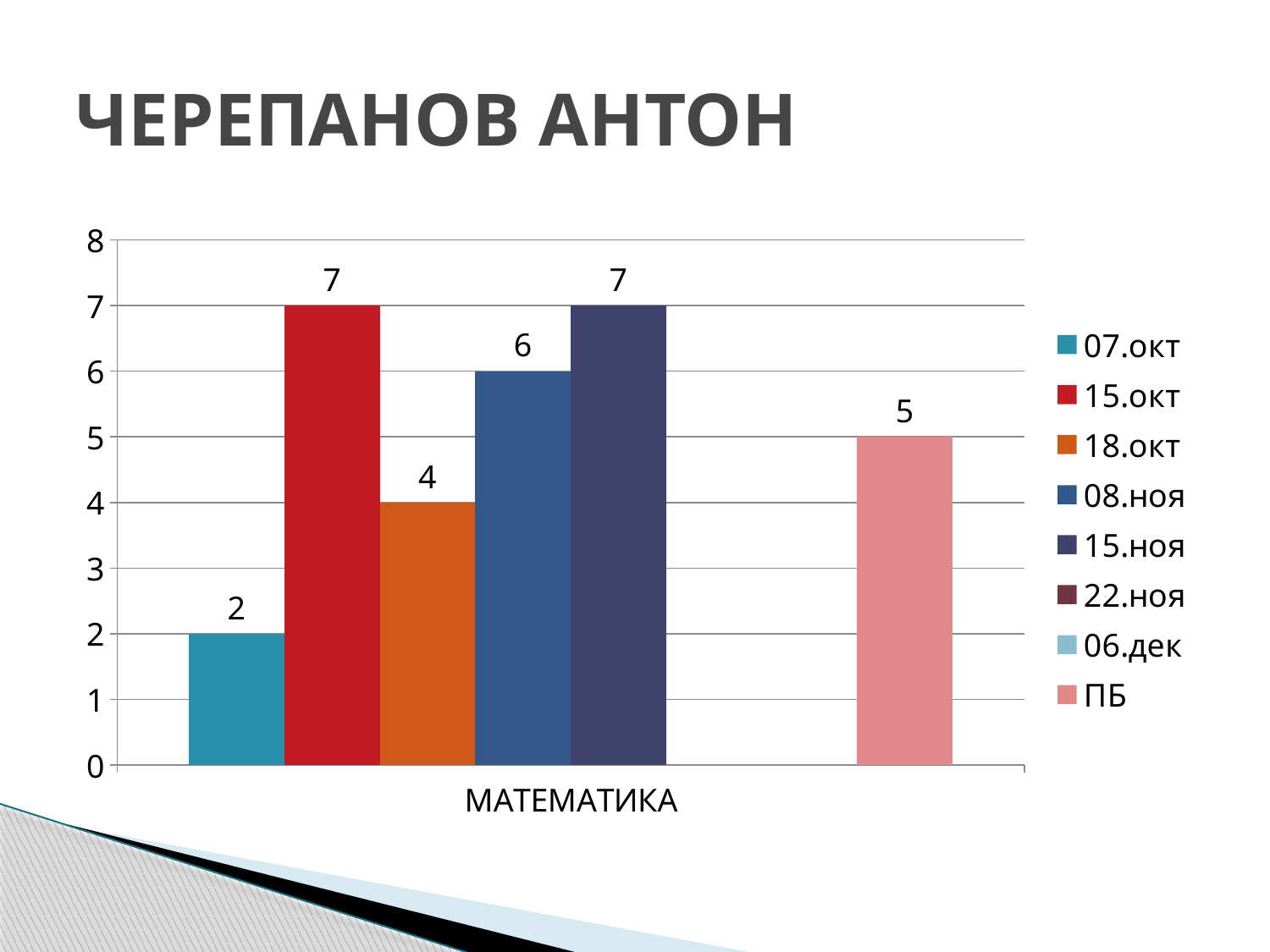
Which is larger, the value for 08.ноя or the value for ПБ? 08.ноя What is the value for 18.окт in МАТЕМАТИКА? 4 What is the difference between the values for 15.окт and 18.окт? 3 What is the value for 15.окт in МАТЕМАТИКА? 7 How many series does the legend list? 8 How many categories are shown on the x axis? 1 What is the value for 08.ноя in МАТЕМАТИКА? 6 Which series has the lowest value in МАТЕМАТИКА? 07.окт What is the value for 07.окт in МАТЕМАТИКА? 2 What kind of chart is shown on the slide? bar chart What is the title of the slide? ЧЕРЕПАНОВ АНТОН What is the value for ПБ in МАТЕМАТИКА? 5